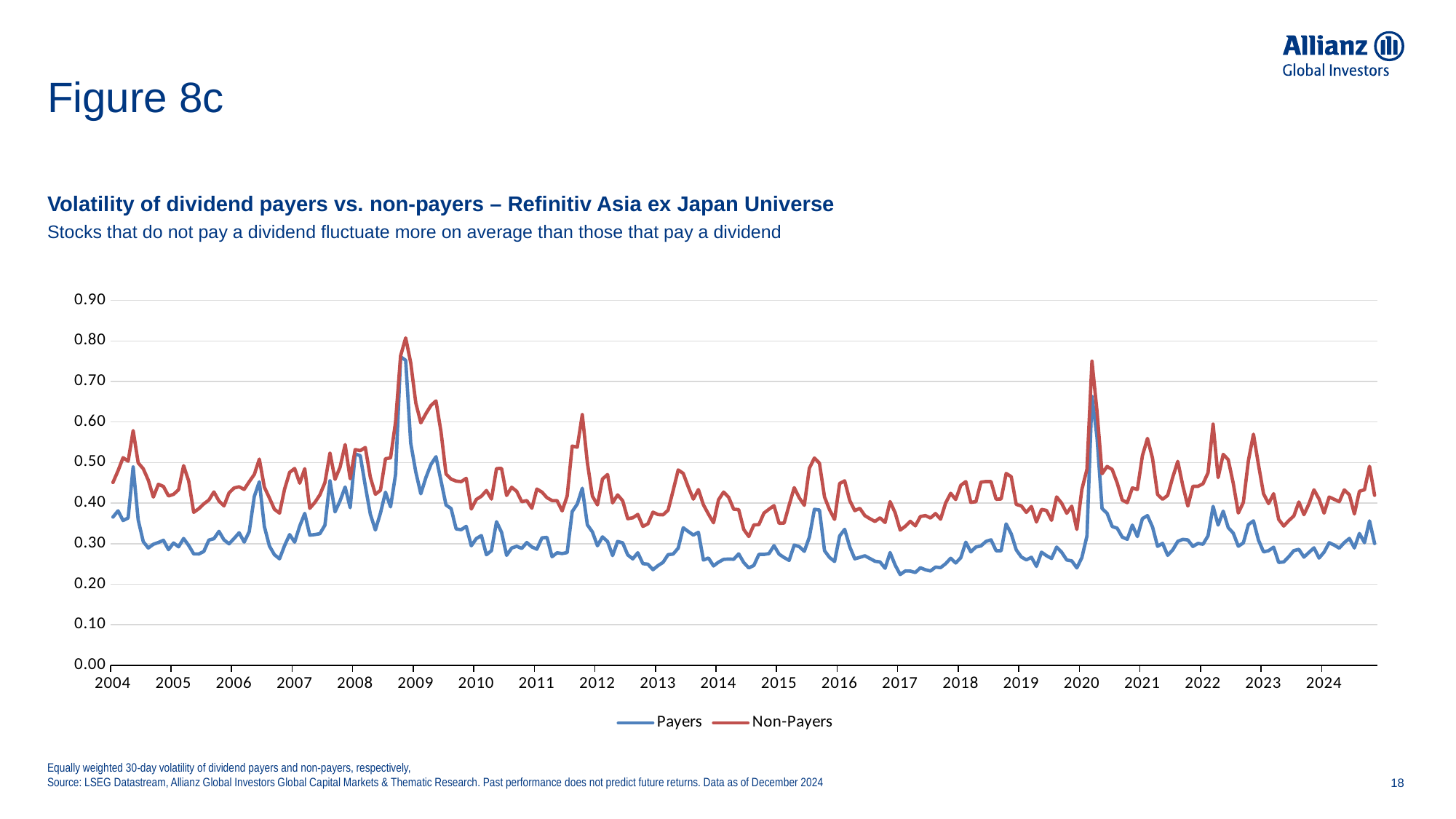
How many year labels are shown on the x axis? 21 Which series reaches the highest value on the chart? Non-Payers Is the peak value for Non-Payers in 2020 greater or less than 0.70? greater How many series does the legend list? 2 What are the two series named in the legend? Payers and Non-Payers Which series is generally higher across the period, Payers or Non-Payers? Non-Payers Is the value for Payers during 2017 greater or less than 0.30? less Which series is drawn in red? Non-Payers What kind of chart is shown on the slide? line chart Is the peak value for Payers around 2009 greater or less than 0.70? greater